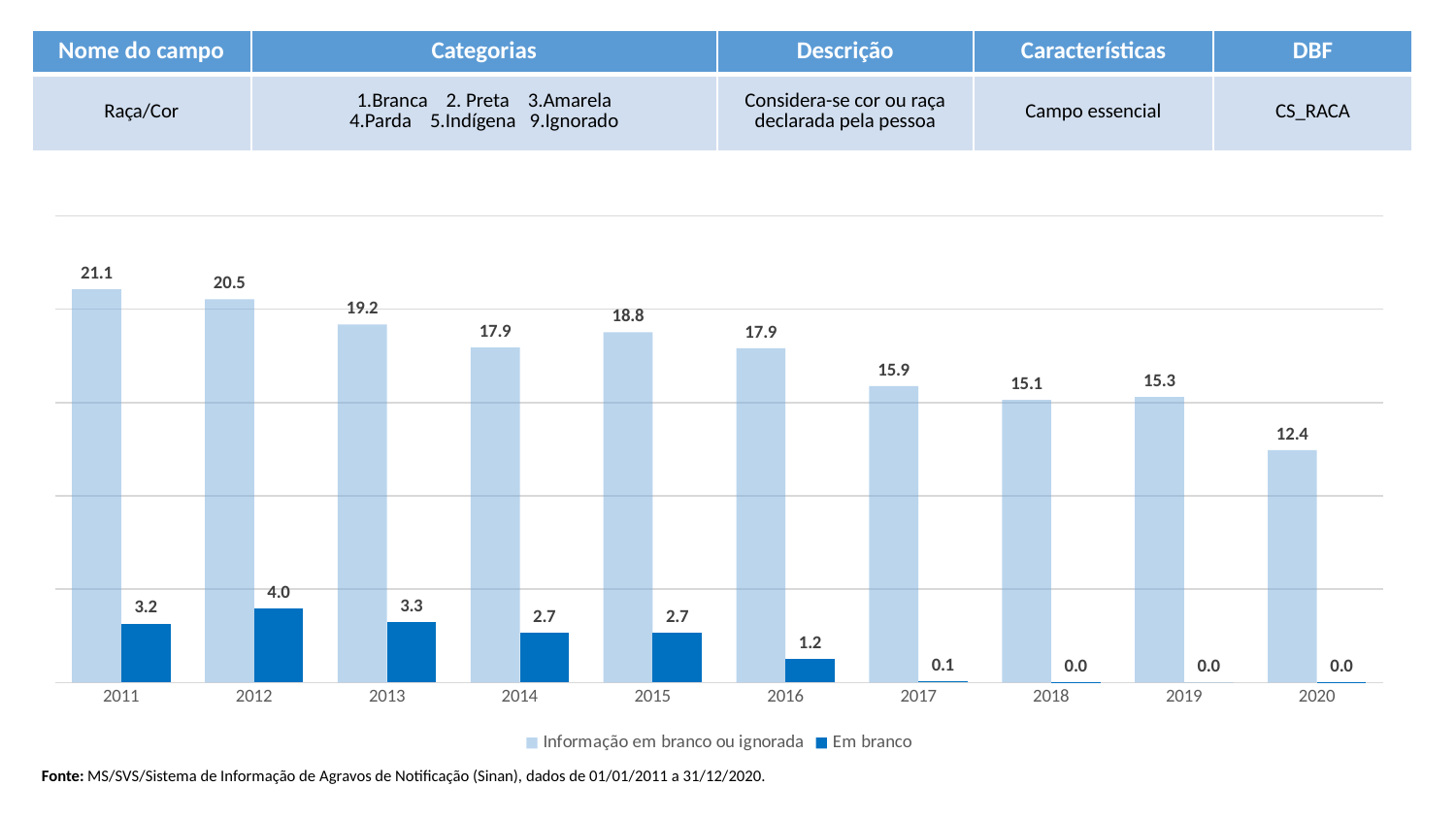
What kind of chart is shown on the slide? Bar chart How many years are shown on the x axis? 10 What is the difference between the 'Informação em branco ou ignorada' values for 2011 and 2020? 8.7 Which year has the highest value for 'Em branco'? 2012 Which is larger: the 'Informação em branco ou ignorada' value for 2015 or for 2016? 2015 Which year has the highest value for 'Informação em branco ou ignorada'? 2011 Does the 'Em branco' series generally rise or fall from 2012 to 2020? Fall What is the value of 'Informação em branco ou ignorada' for 2020? 12.4 What is the value of 'Em branco' for 2012? 4.0 How many series does the legend list? 2 Which year has the lowest value for 'Informação em branco ou ignorada'? 2020 What is the value of 'Informação em branco ou ignorada' for 2011? 21.1